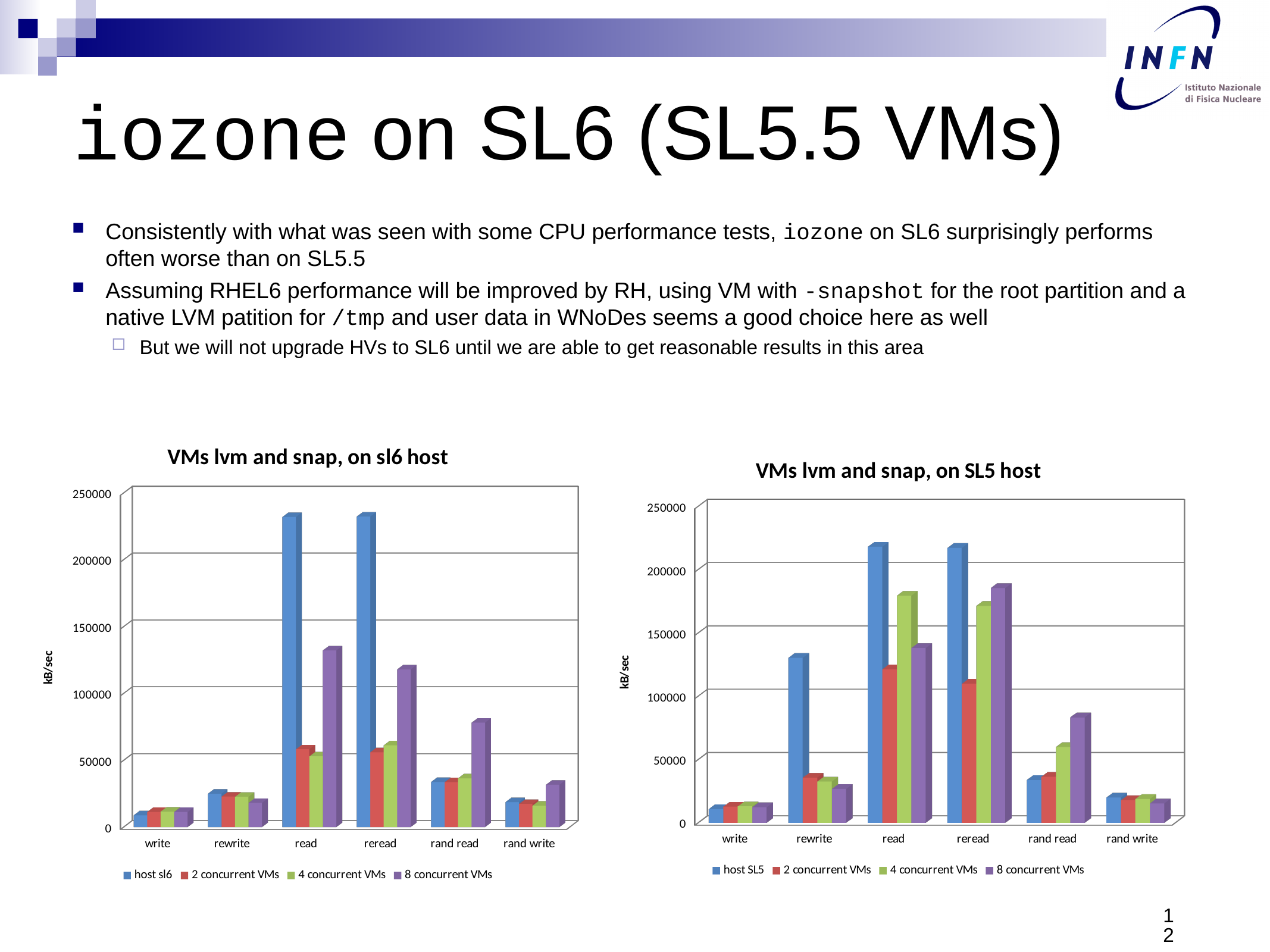
How many categories are shown on the x axis of the 'VMs lvm and snap, on sl6 host' chart? 6 How many series does the legend of the 'VMs lvm and snap, on SL5 host' chart list? 4 What is the first legend entry of the 'VMs lvm and snap, on sl6 host' chart? host sl6 What is the y-axis label of the 'VMs lvm and snap, on SL5 host' chart? kB/sec In the 'VMs lvm and snap, on sl6 host' chart, for the rand read category, which is larger: host sl6 or 8 concurrent VMs? 8 concurrent VMs In the 'VMs lvm and snap, on sl6 host' chart, which category has the lowest host sl6 value? write What kind of chart is the 'VMs lvm and snap, on sl6 host' chart? bar chart In the 'VMs lvm and snap, on SL5 host' chart, is the 8 concurrent VMs value for reread greater or less than 150000? greater In the 'VMs lvm and snap, on SL5 host' chart, which series has the highest value in the rewrite category? host SL5 In the 'VMs lvm and snap, on SL5 host' chart, is the host SL5 value for rewrite greater or less than 100000? greater In the 'VMs lvm and snap, on sl6 host' chart, is the host sl6 value for read greater or less than 200000? greater In the 'VMs lvm and snap, on SL5 host' chart, for the read category, which is larger: 2 concurrent VMs or 4 concurrent VMs? 4 concurrent VMs